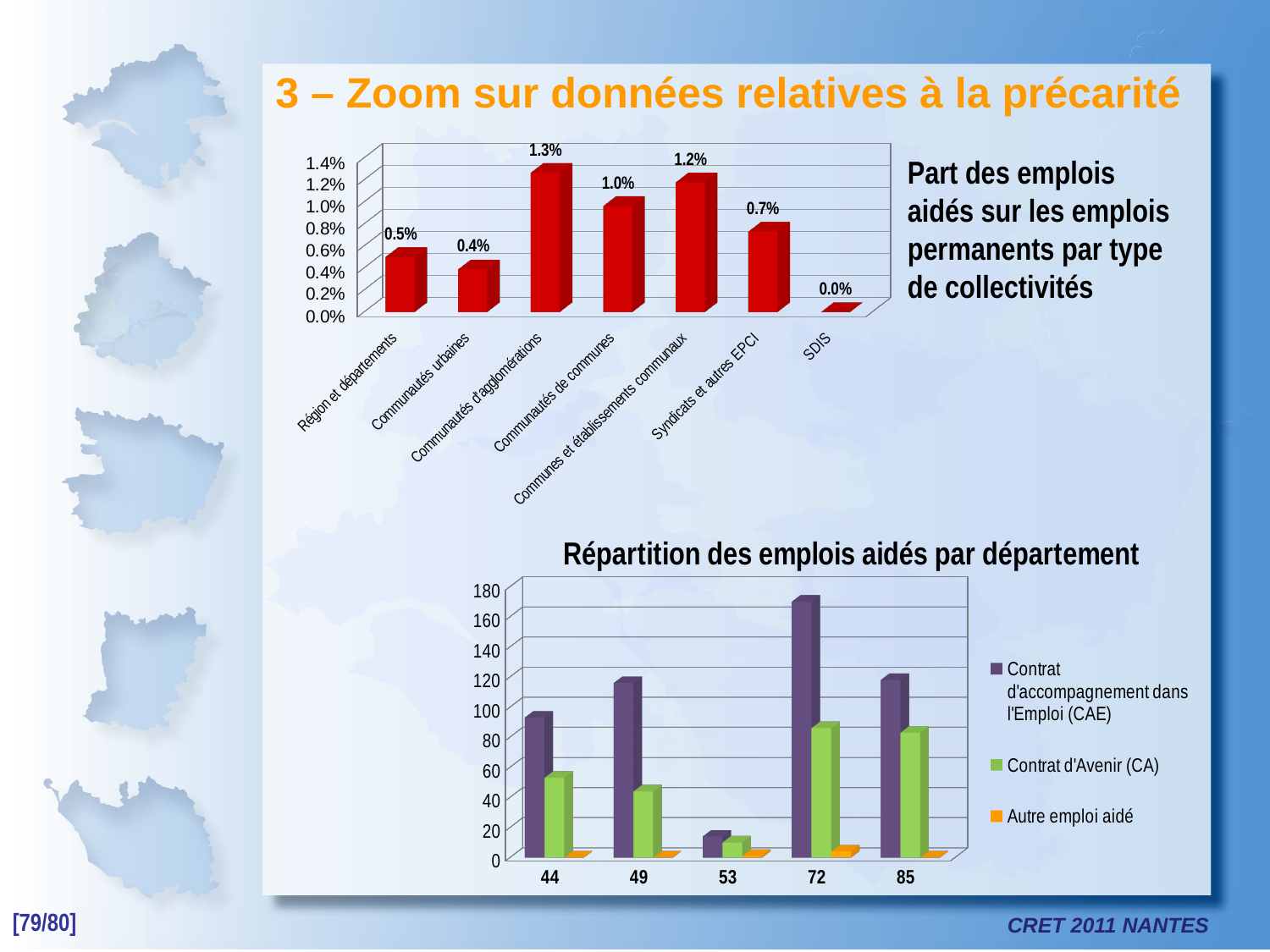
What kind of chart is the bottom chart? Bar chart In the top chart (Part des emplois aidés sur les emplois permanents par type de collectivités), what is the value for Communautés d'agglomérations? 1.3% In the bottom chart, is the value of Contrat d'accompagnement dans l'Emploi (CAE) for département 72 greater or less than 160? greater In the top chart, which type of collectivité has the highest share of emplois aidés? Communautés d'agglomérations In the top chart, which is larger: the value for Région et départements or the value for Communautés de communes? Communautés de communes In the bottom chart, which département has the highest value for Contrat d'accompagnement dans l'Emploi (CAE)? 72 In the top chart, what is the difference between the values for Communes et établissements communaux and Communautés urbaines? 0.8% In the bottom chart, is the value of Contrat d'Avenir (CA) for département 53 greater or less than 20? less In the top chart, what is the value for Syndicats et autres EPCI? 0.7% In the top chart, which type of collectivité has the lowest share of emplois aidés? SDIS How many categories are shown in the top chart? 7 In the bottom chart (Répartition des emplois aidés par département), how many series does the legend list? 3